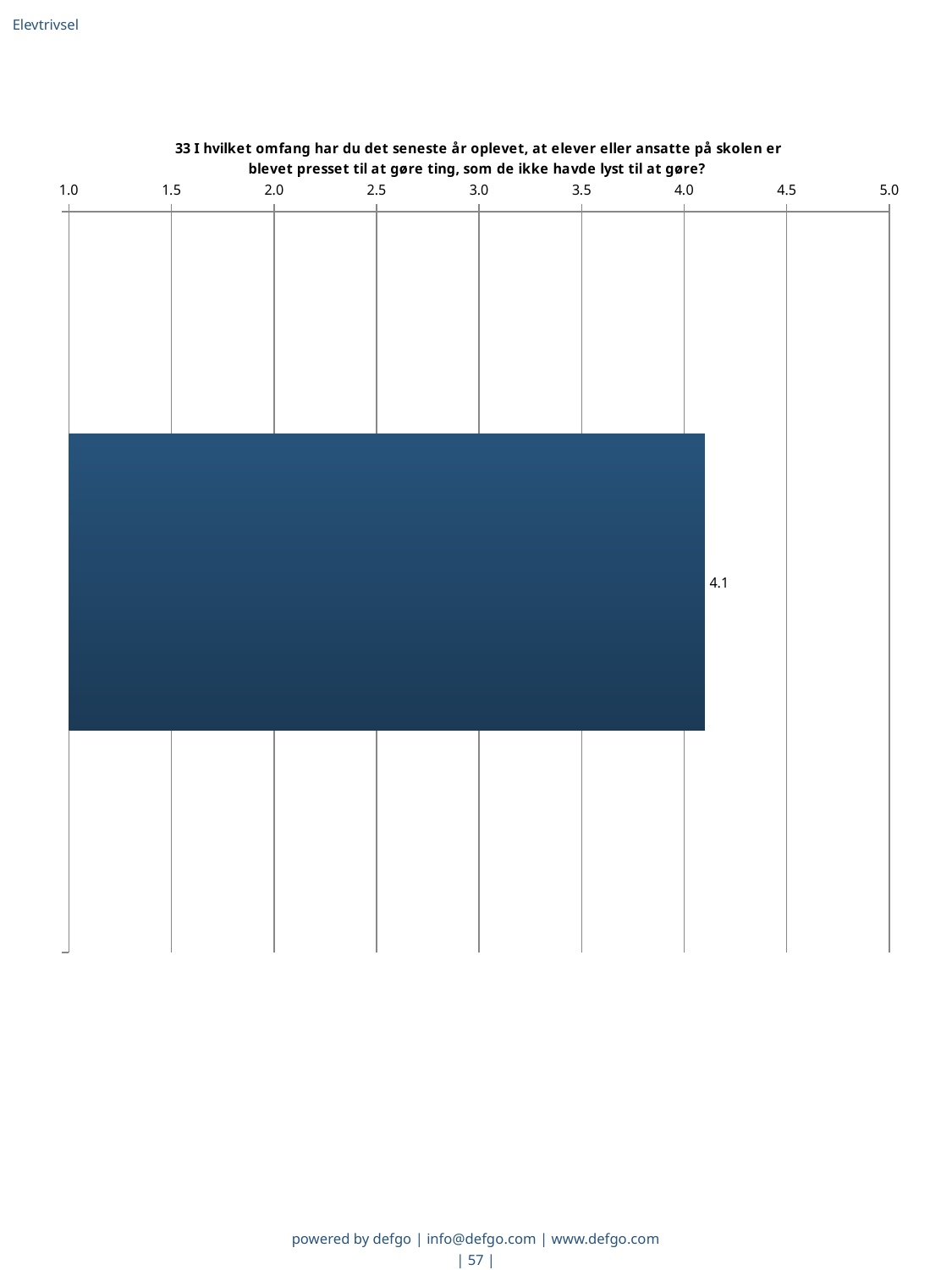
What is the lowest value shown on the chart's horizontal axis? 1.0 How many bars are plotted in the chart? 1 Is the value of the bar greater or less than 3.5? greater Is the value of the bar greater or less than 3.0? greater What value is shown on the bar in the chart? 4.1 What kind of chart is shown on the slide? bar chart What is the highest value shown on the chart's horizontal axis? 5.0 Is the value of the bar greater or less than 4.5? less